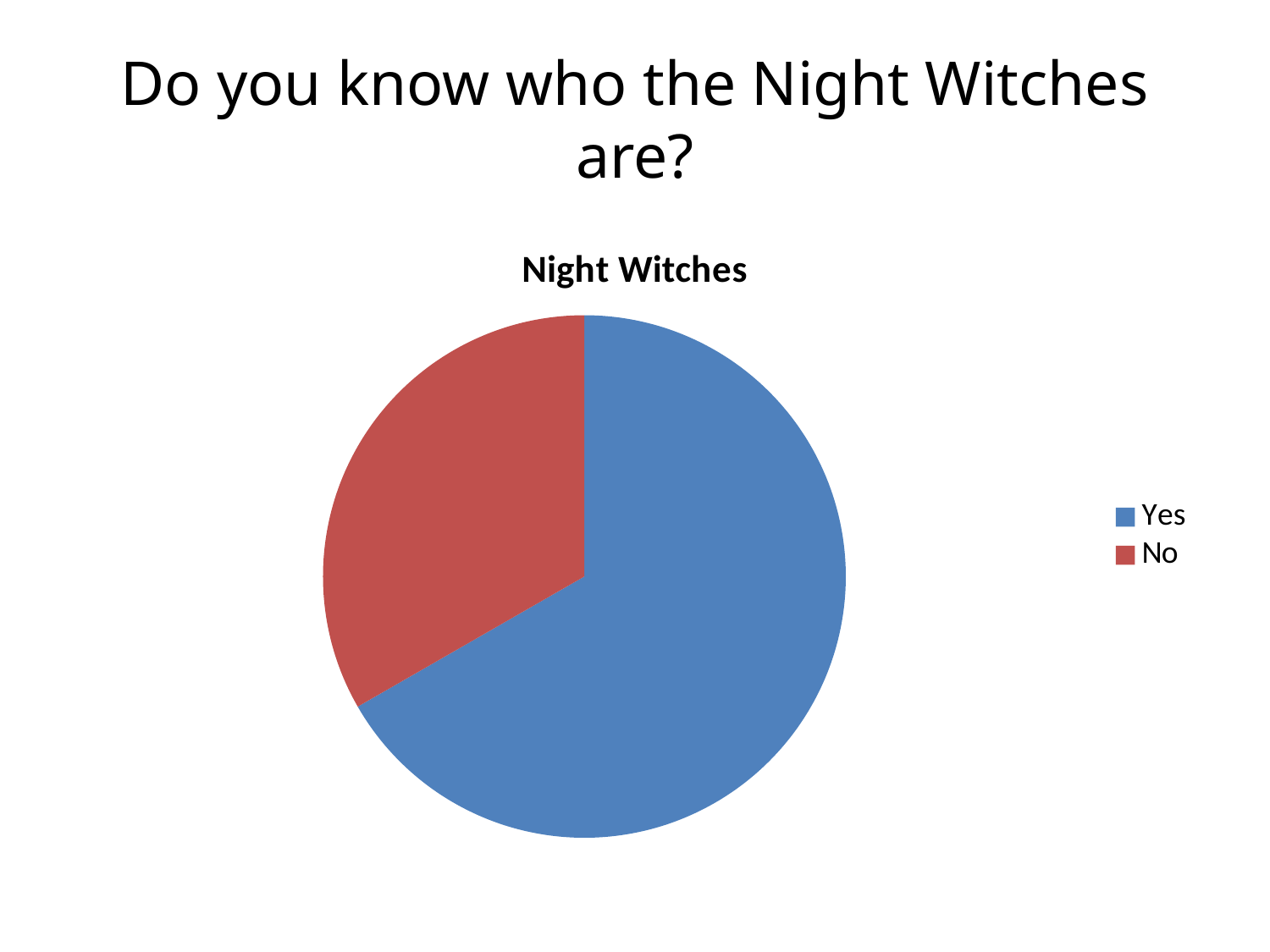
Is the share of the Yes slice greater or less than half of the pie? greater How many slices does the pie chart have? 2 Which slice is the largest in the pie chart? Yes Is the share of the No slice greater or less than half of the pie? less Which slice is the smallest in the pie chart? No What colour is the Yes slice? blue How many entries does the legend list? 2 What kind of chart is shown on the slide? pie chart Which is larger, the Yes slice or the No slice? Yes What is the title of the chart? Night Witches